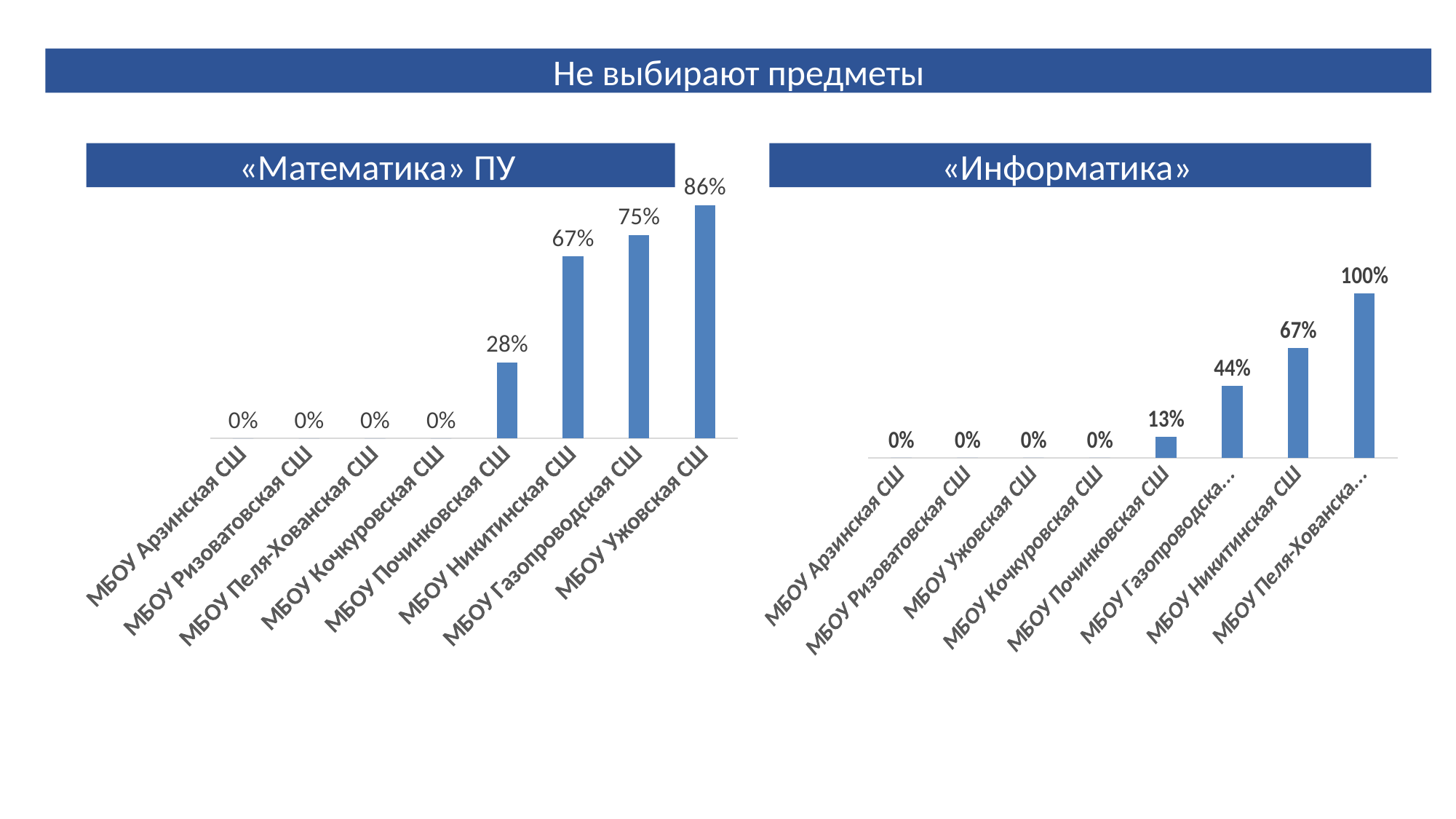
In the «Математика» ПУ chart, what is the value for МБОУ Починковская СШ? 28% In the «Математика» ПУ chart, how many schools are shown on the x axis? 8 In the «Информатика» chart, which is larger: the value for МБОУ Никитинская СШ or МБОУ Починковская СШ? МБОУ Никитинская СШ In the «Математика» ПУ chart, what is the value for МБОУ Газопроводская СШ? 75% In the «Информатика» chart, do the values rise or fall from left to right along the x axis? Rise In the «Информатика» chart, what is the value for МБОУ Починковская СШ? 13% In the «Математика» ПУ chart, which school has the highest value? МБОУ Ужовская СШ In the «Математика» ПУ chart, how many schools have a value of 0%? 4 In the «Информатика» chart, what is the value for МБОУ Ужовская СШ? 0% In the «Информатика» chart, what is the value for МБОУ Никитинская СШ? 67% In the «Математика» ПУ chart, what is the difference between МБОУ Ужовская СШ and МБОУ Никитинская СШ? 19% What type of chart is the «Информатика» chart? Bar chart